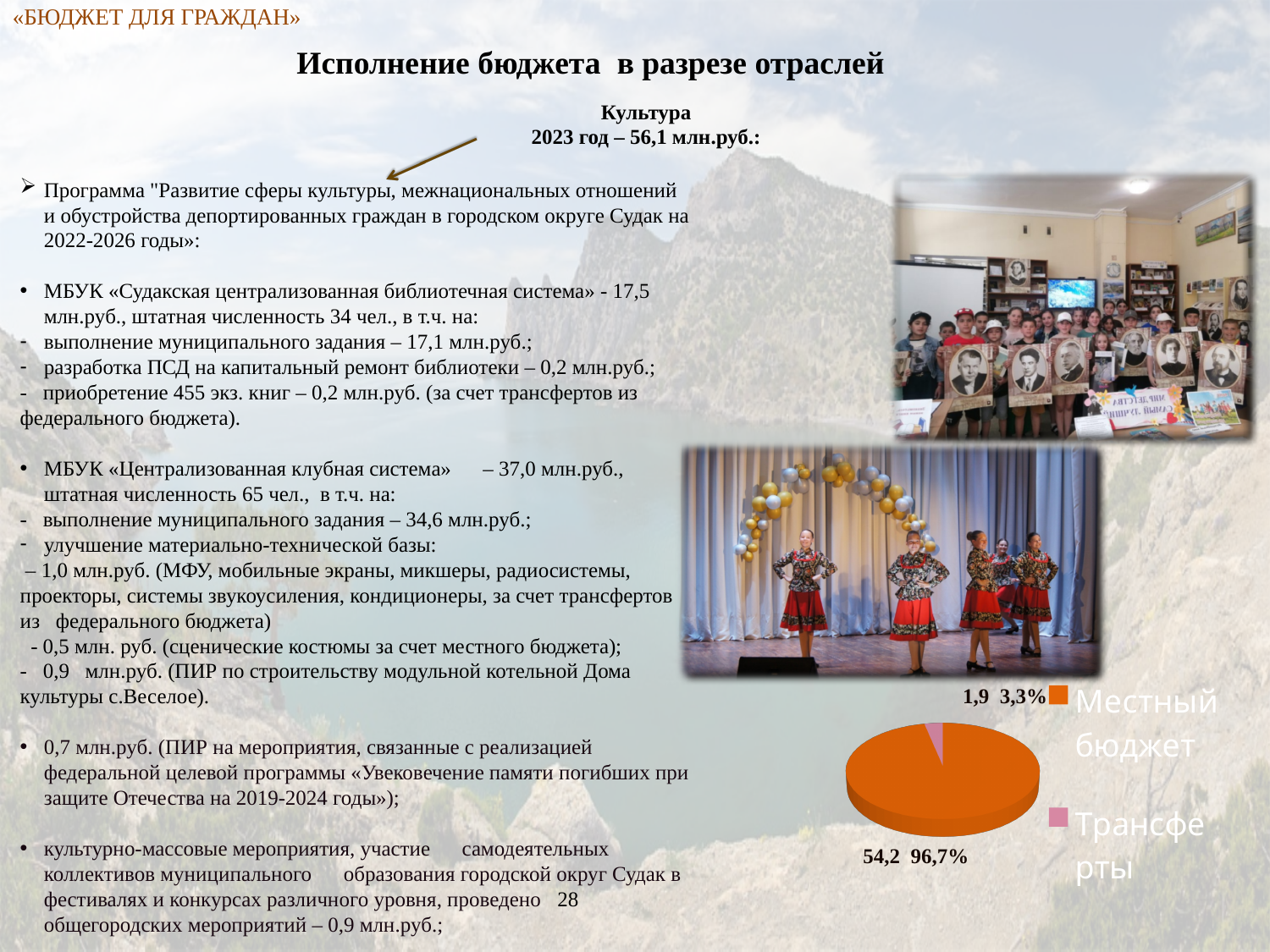
How many series does the legend of the pie chart list? 2 What is the difference between the Местный бюджет value and the Трансферты value in the pie chart? 52,3 What value is labelled for the Трансферты slice of the pie chart? 1,9 What value is labelled for the Местный бюджет slice of the pie chart? 54,2 Which slice of the pie chart is the largest? Местный бюджет What share of the pie does the Местный бюджет slice represent? 96,7% What kind of chart is shown at the bottom right of the slide? pie chart Which is larger in the pie chart, Местный бюджет or Трансферты? Местный бюджет Which slice of the pie chart is the smallest? Трансферты What share of the pie does the Трансферты slice represent? 3,3% How many slices does the pie chart have? 2 Which legend entry of the pie chart is shown in orange? Местный бюджет